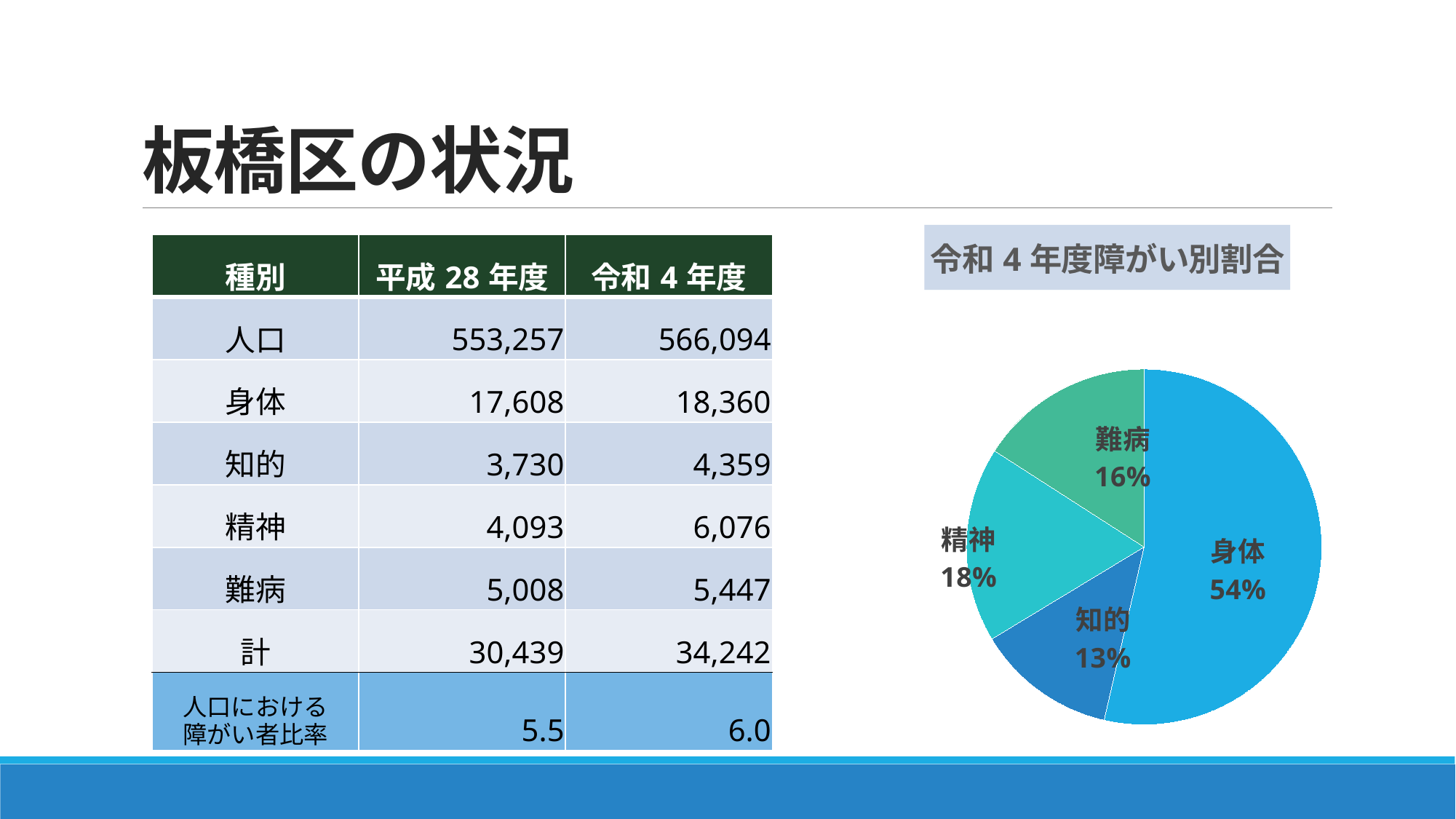
Which slice of the pie chart is the largest? 身体 What is the difference in percentage points between the 身体 slice and the 精神 slice? 36 What share of the pie does 身体 have? 54% Is the share for 身体 greater or less than 50%? greater What share of the pie does 難病 have? 16% How many slices does the pie chart have? 4 What share of the pie does 知的 have? 13% Which slice is larger, 精神 or 難病? 精神 What kind of chart is shown on the slide? pie chart Which slice of the pie chart is the smallest? 知的 What is the title of the pie chart? 令和４年度障がい別割合